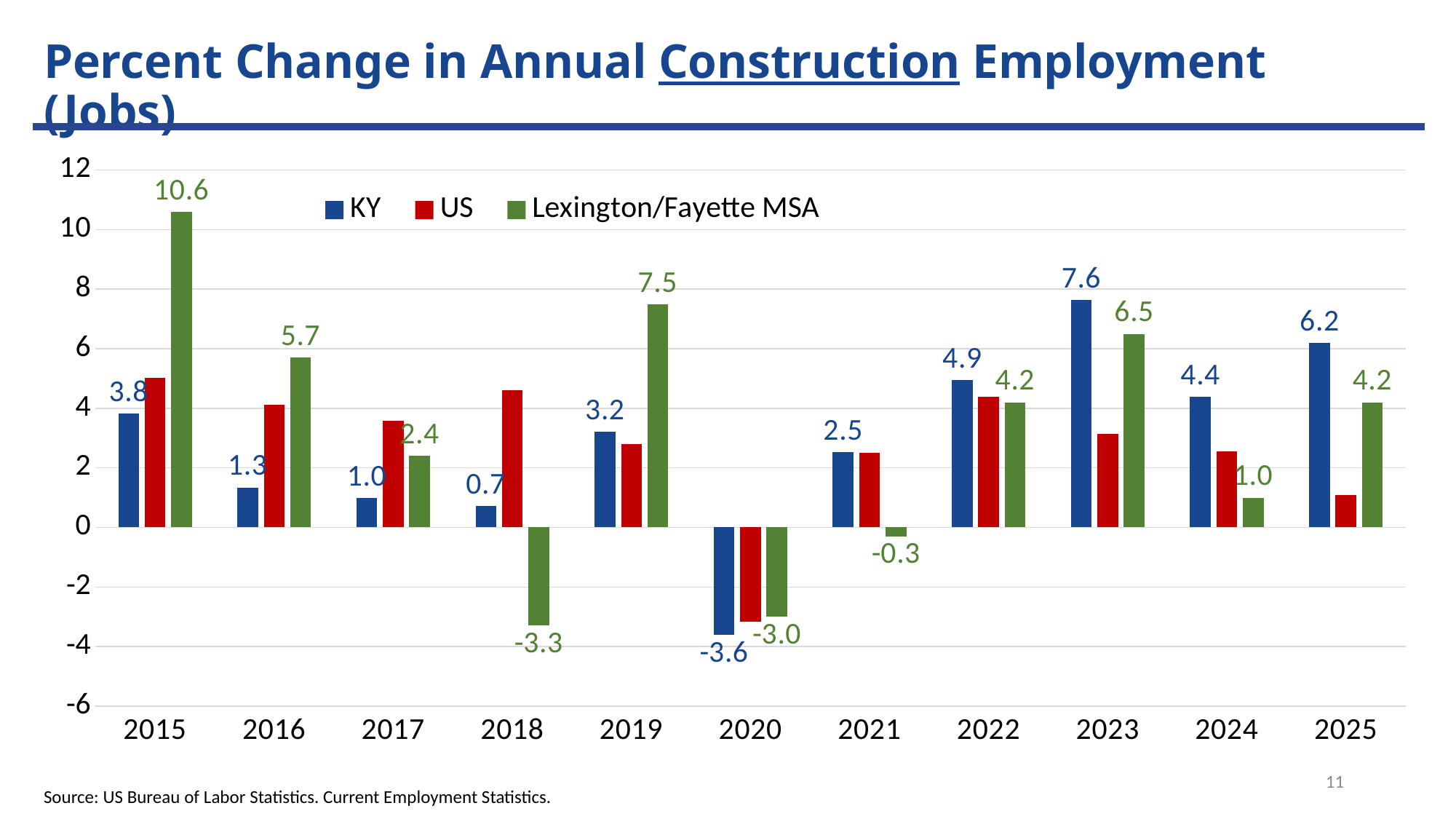
Is the value for US in 2018 greater or less than 4? greater What is the value for Lexington/Fayette MSA in 2015? 10.6 Which is larger in 2024, the KY value or the Lexington/Fayette MSA value? KY What is the value for KY in 2023? 7.6 How many series does the legend list? 3 What colour represents the US series? Red In which year is the Lexington/Fayette MSA value lowest? 2018 In which year is the KY value highest? 2023 What kind of chart is shown on the slide? Bar chart What is the value for Lexington/Fayette MSA in 2021? -0.3 What is the difference between the Lexington/Fayette MSA value and the KY value in 2019? 4.3 How many years are shown on the x axis? 11